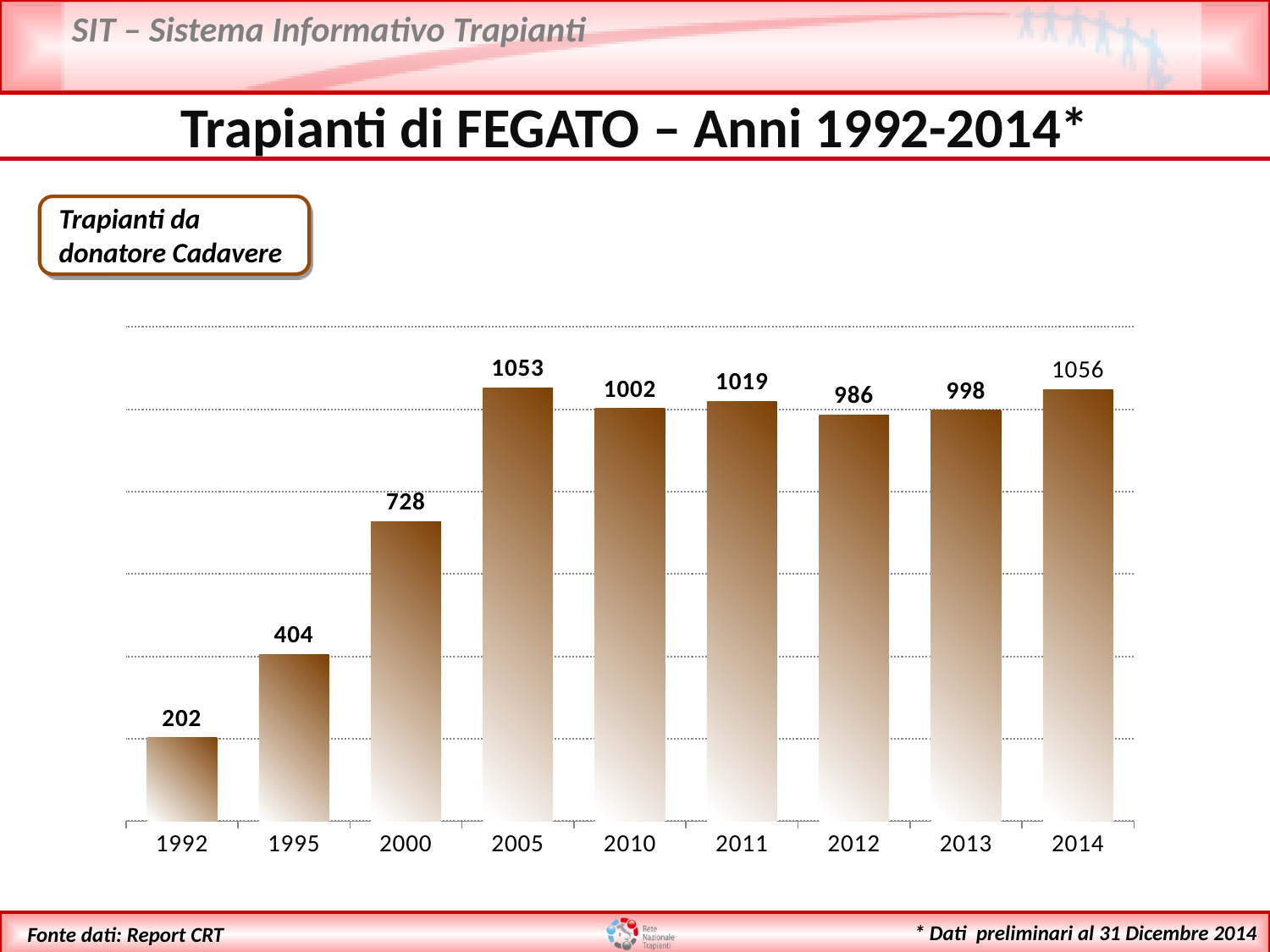
What is the difference between the values for 2000 and 1995? 324 What kind of chart is shown on the slide? bar chart Which year has the highest value? 2014 What is the difference between the values for 2014 and 2013? 58 What is the value for 2005? 1053 Which is larger, the value for 2011 or the value for 2010? 2011 What is the value for 1992? 202 Which year has the lowest value? 1992 What is the value for 2012? 986 What is the title of the slide's chart? Trapianti di FEGATO – Anni 1992-2014* Do the values rise or fall from 1992 to 2005? rise How many years are shown on the x axis? 9